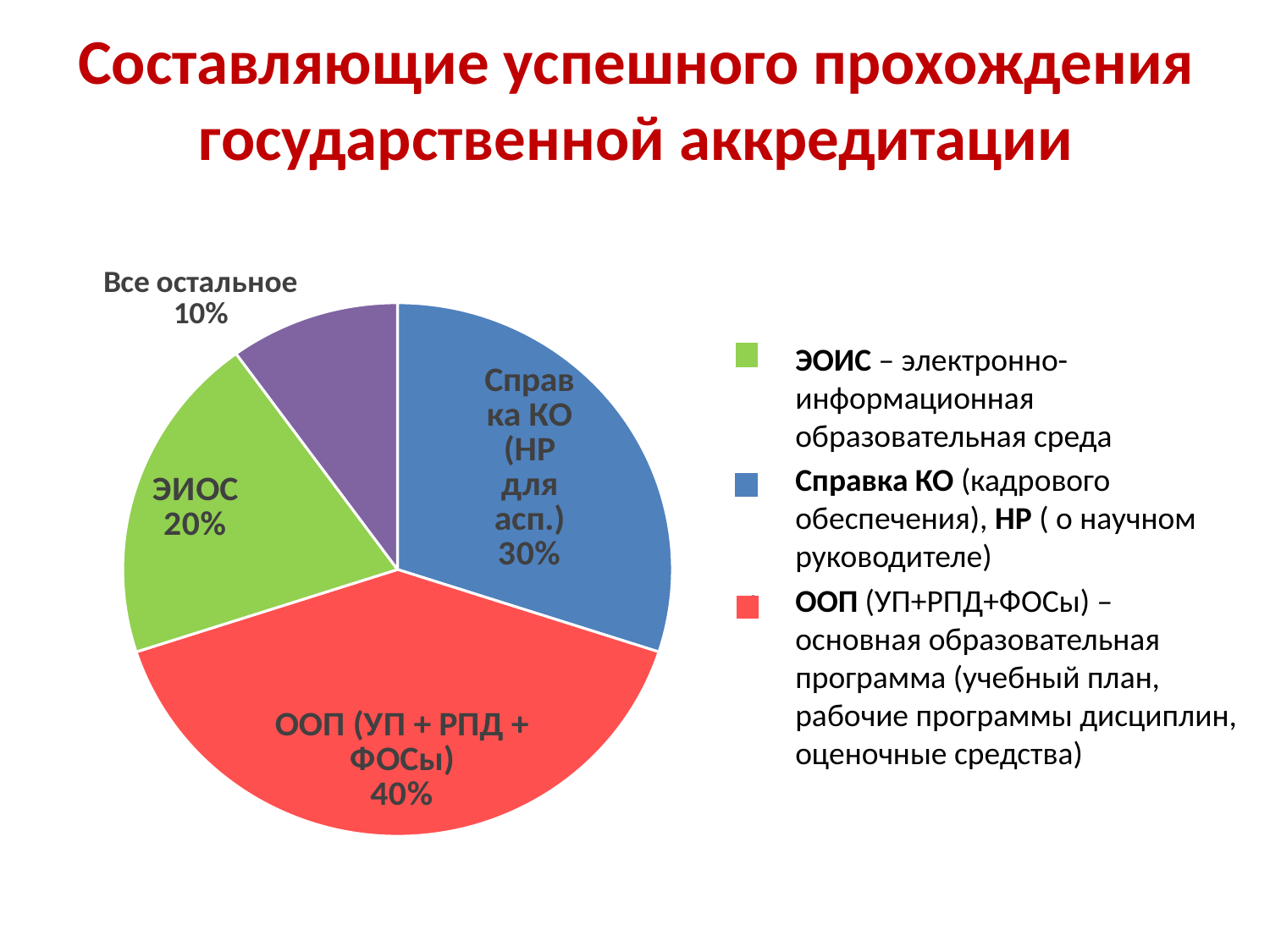
What share of the pie does the slice "ЭИОС" have? 20% What is the difference in percentage points between the "Справка КО (НР для асп.)" slice and the "Все остальное" slice? 20% What share of the pie does the slice "Справка КО (НР для асп.)" have? 30% Which slice of the pie chart is the smallest? Все остальное What share of the pie does the slice "ООП (УП + РПД + ФОСы)" have? 40% What is the difference in percentage points between the "ООП (УП + РПД + ФОСы)" slice and the "ЭИОС" slice? 20% What colour is the "ЭИОС" slice in the pie chart? green How many slices does the pie chart have? 4 Which slice of the pie chart is the largest? ООП (УП + РПД + ФОСы) Which is larger: the "Справка КО (НР для асп.)" slice or the "ЭИОС" slice? Справка КО (НР для асп.) What kind of chart is shown on the slide? pie chart